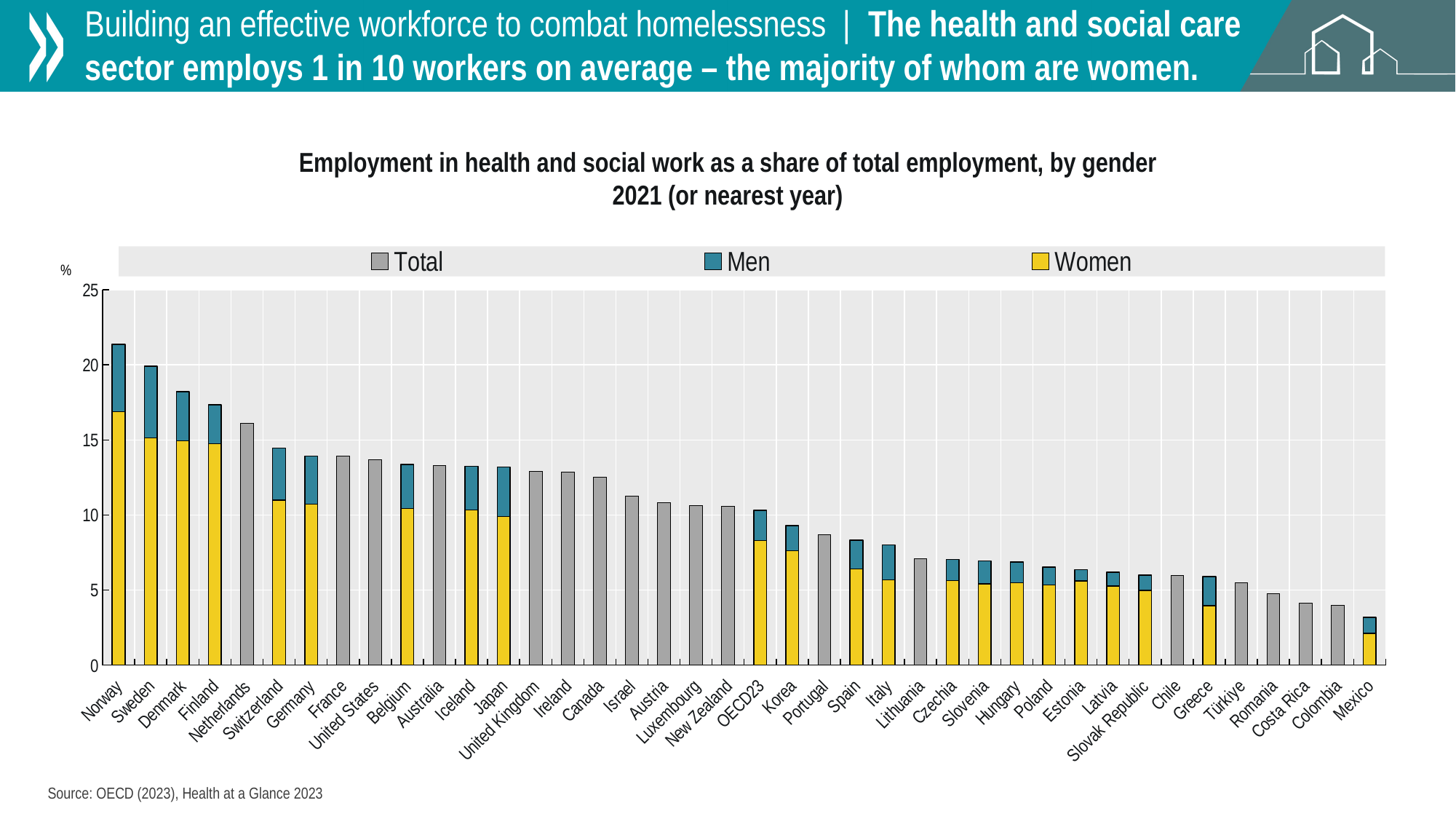
Which country has the lowest total share of employment in health and social work? Mexico Which country has the highest total share of employment in health and social work? Norway How many series does the legend list? 3 Is the Women value for Mexico greater or less than 5? less How many countries or groups are shown along the x axis? 40 Is the total value for Norway greater or less than 20? greater Do the total values rise or fall moving from left to right along the x axis? fall Which colour represents the Women series in the legend? yellow Is the total value for Netherlands greater or less than 15? greater Which has a larger total value, Netherlands or Switzerland? Netherlands What kind of chart is shown on the slide? bar chart